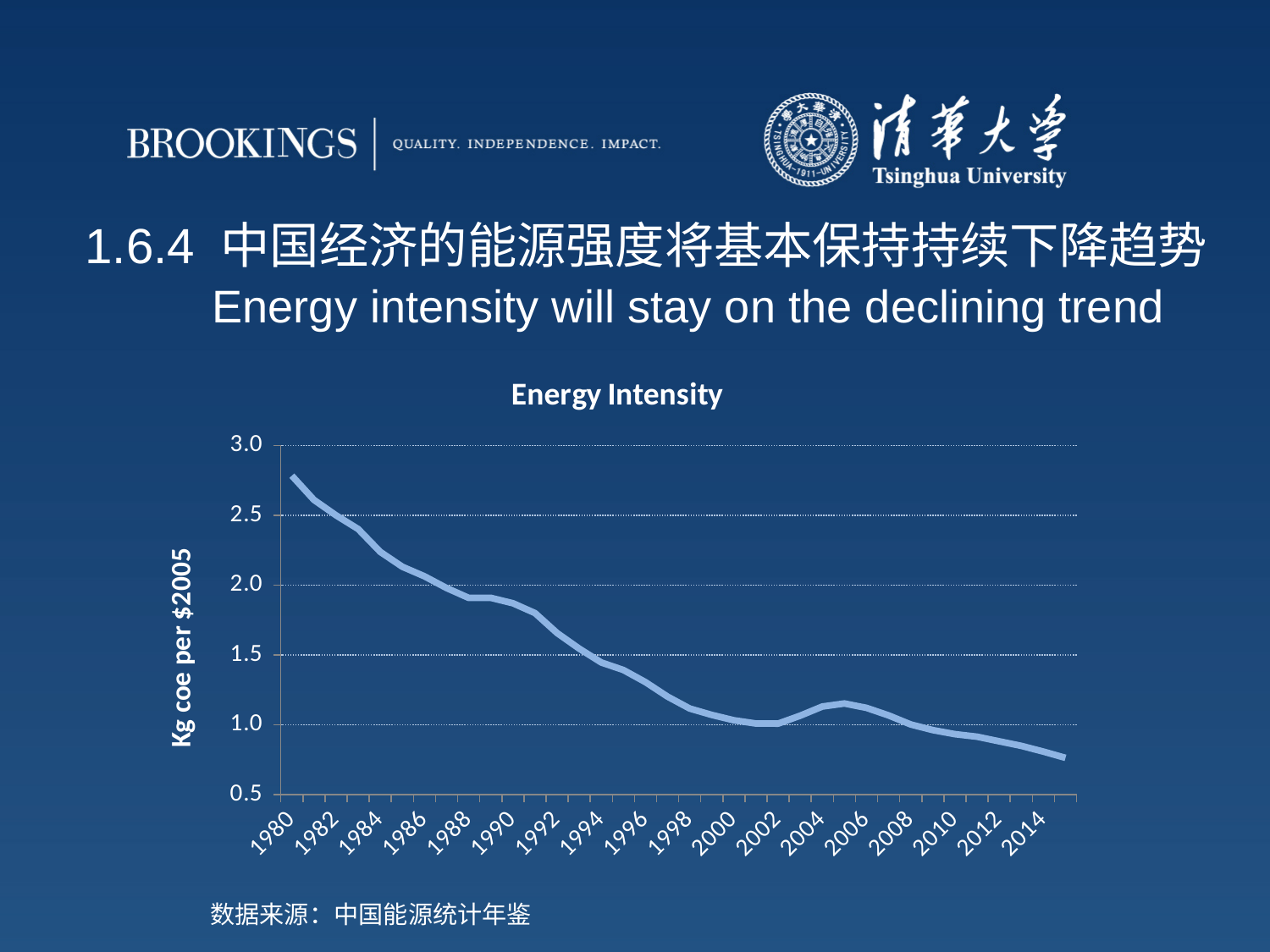
Is the value for 1990 greater or less than 2.0? less How many year labels are shown on the horizontal axis? 18 Do the values in the chart generally rise or fall from 1980 to 2014? fall Is the value for 1984 greater or less than 2.0? greater Is the value for 1980 greater or less than 2.5? greater Which year has the larger energy intensity value, 1990 or 2000? 1990 Which year has the highest energy intensity value in the chart? 1980 What is the label on the vertical axis of the chart? Kg coe per $2005 What is the title of the chart? Energy Intensity What kind of chart is shown on the slide? line chart